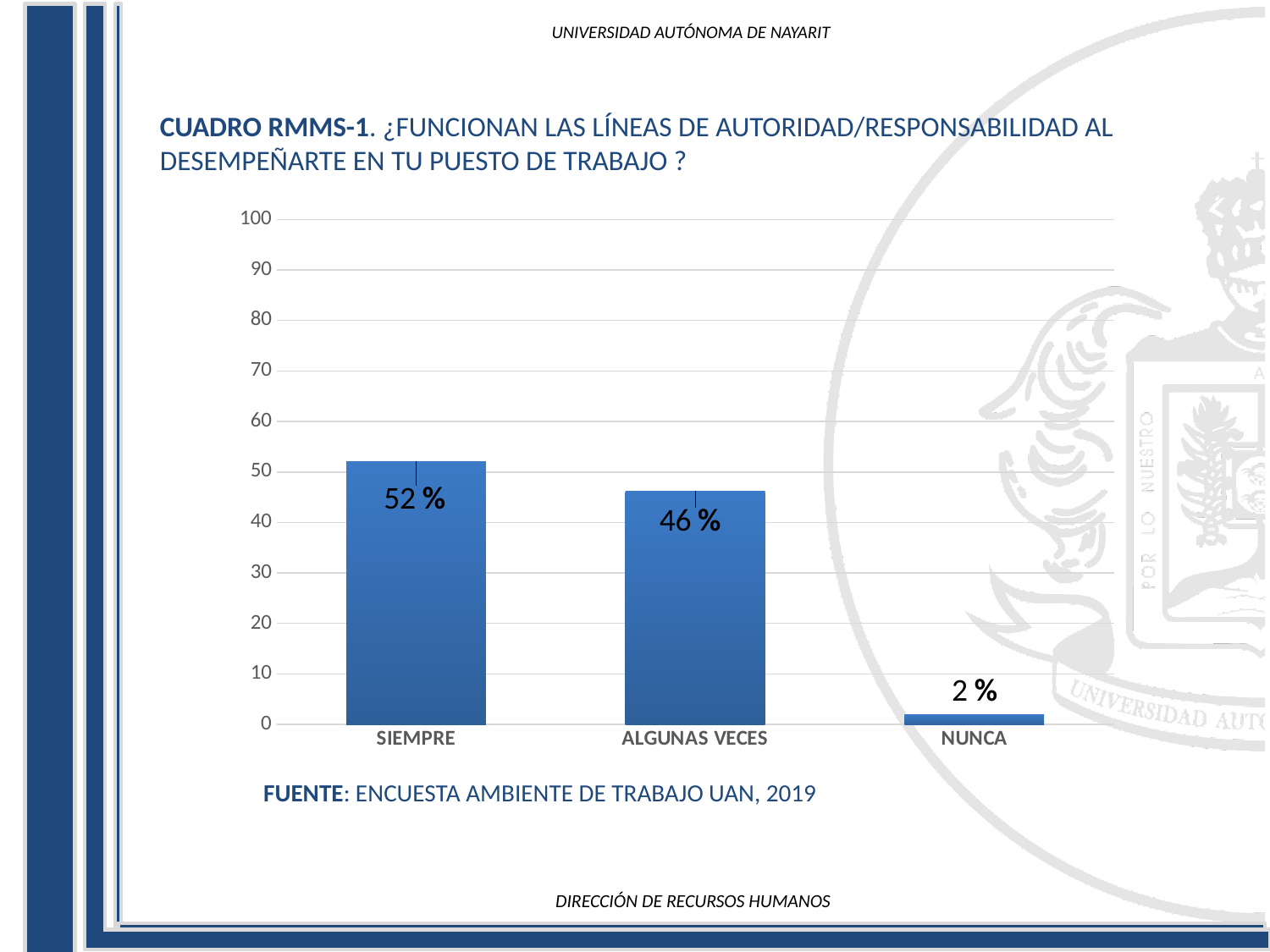
What is the value for ALGUNAS VECES? 46 % Do the values rise or fall from left to right along the x axis? fall What is the value for SIEMPRE? 52 % Is the value for SIEMPRE greater or less than 50? greater Which category has the lowest value? NUNCA What is the value for NUNCA? 2 % What is the difference between the values for ALGUNAS VECES and NUNCA? 44 % Which category has the highest value? SIEMPRE What kind of chart is shown on the slide? bar chart What is the difference between the values for SIEMPRE and ALGUNAS VECES? 6 % Which is larger, the value for SIEMPRE or the value for ALGUNAS VECES? SIEMPRE How many categories are shown on the x axis? 3